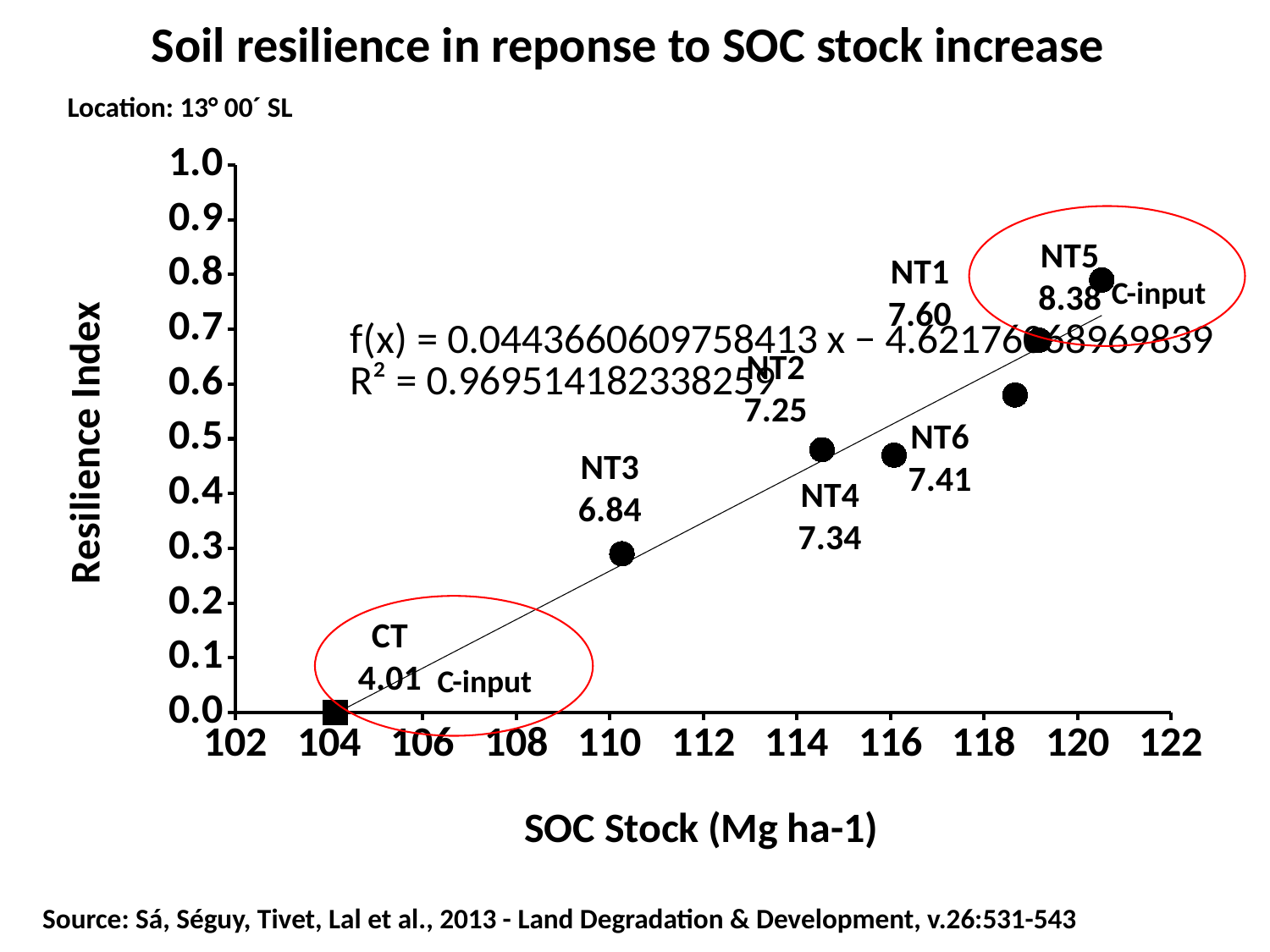
Which labelled point has the highest Resilience Index? NT5 What kind of chart is shown on the slide? Scatter chart What is the label of the x axis? SOC Stock (Mg ha-1) Does the Resilience Index rise or fall as SOC Stock increases along the x axis? rises Which labelled point has the lowest Resilience Index? CT Which has a higher Resilience Index, NT3 or NT4? NT4 Is the Resilience Index for NT5 greater or less than 0.7? greater Is the Resilience Index for NT3 greater or less than 0.4? less What is the Resilience Index for CT? 0.0 What R² value is printed on the chart for the trendline? 0.969514182338259 What is the title of the chart? Soil resilience in reponse to SOC stock increase How many data points are plotted on the chart? 7